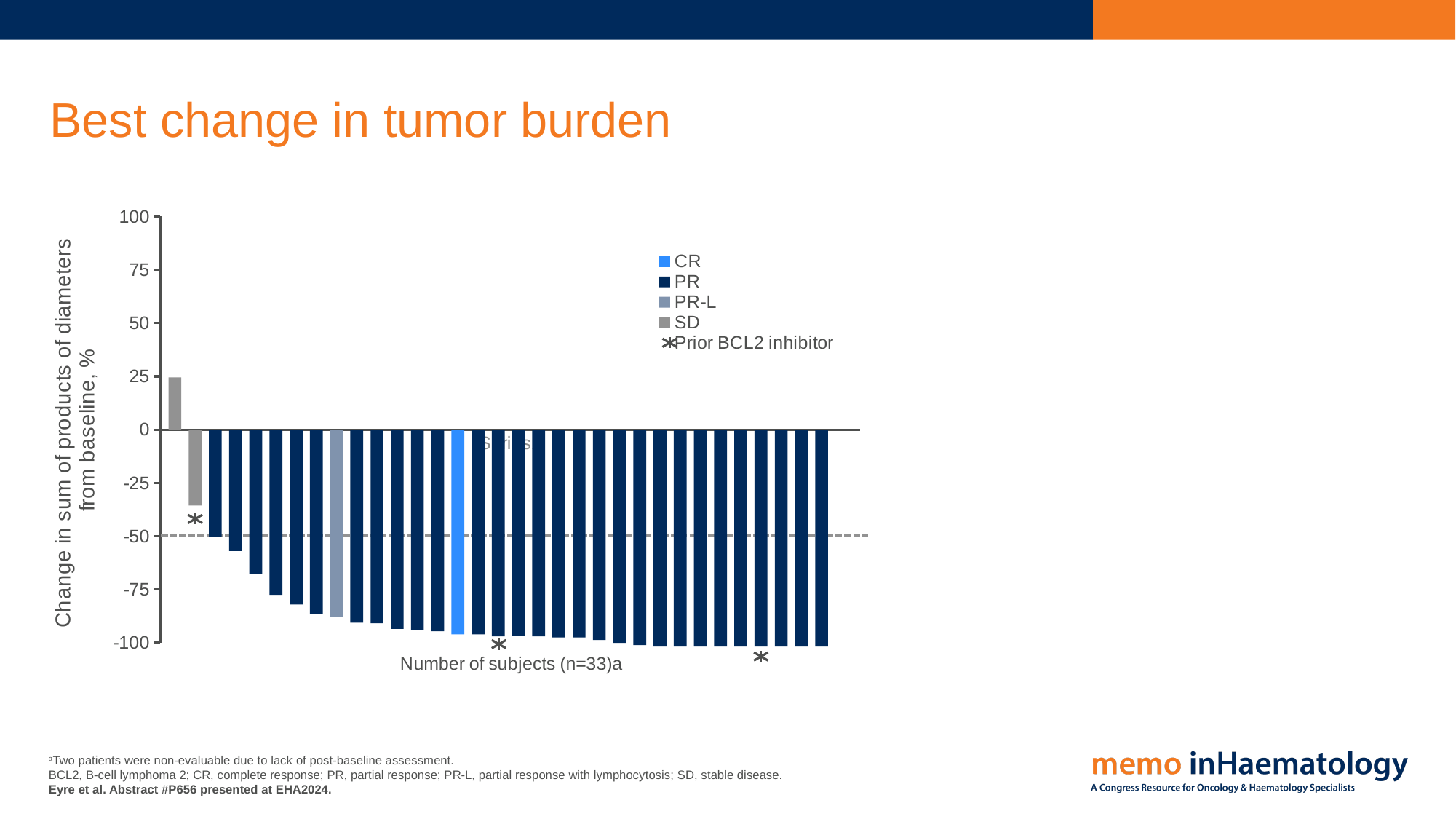
Is the value for the light blue CR bar greater or less than -75? less According to the x-axis label, how many subjects are included in the chart? n=33 How many entries does the chart legend list? 5 How many bars are coloured gray (SD) in the chart? 2 How many bars are marked with an asterisk for prior BCL2 inhibitor? 3 Which bar has the highest value in the chart? The leftmost (SD) bar What is the title of the chart on the slide? Best change in tumor burden Do the bar values rise or fall moving from left to right along the x axis? fall How many bars in the chart have a positive value (above 0)? 1 What does the asterisk symbol in the legend indicate? Prior BCL2 inhibitor What kind of chart is shown on the slide? Bar chart Is the value for the leftmost bar greater or less than 0? greater